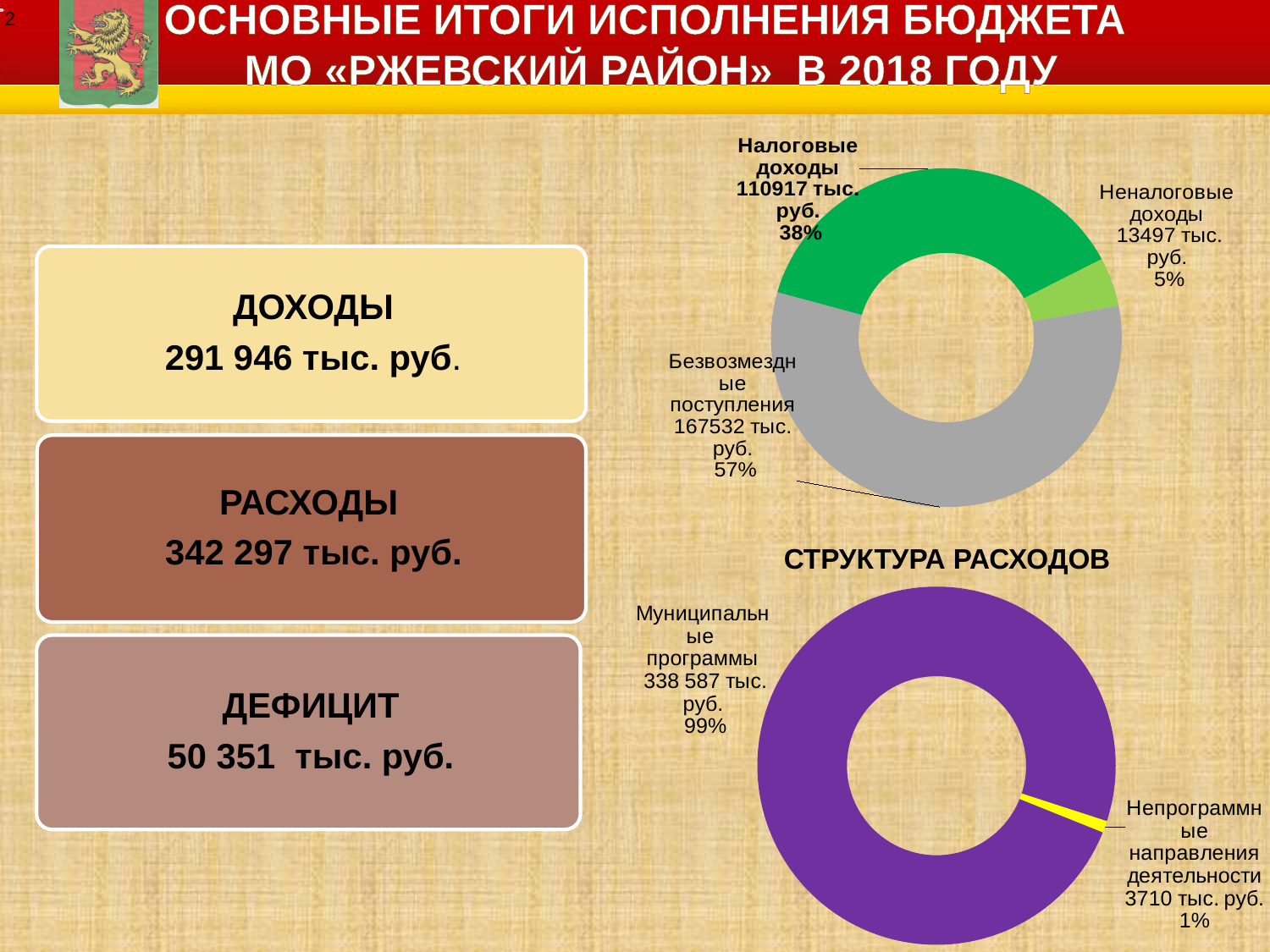
What kind of chart is the chart titled СТРУКТУРА РАСХОДОВ? Doughnut chart In the upper doughnut chart on the slide, how many categories are shown? 3 In the upper doughnut chart on the slide, which category is the largest? Безвозмездные поступления In the upper doughnut chart on the slide, what is the value for Налоговые доходы? 110917 тыс. руб. In the chart titled СТРУКТУРА РАСХОДОВ, which category is larger, Муниципальные программы or Непрограммные направления деятельности? Муниципальные программы In the upper doughnut chart on the slide, what share does Безвозмездные поступления have? 57% In the chart titled СТРУКТУРА РАСХОДОВ, what share does Непрограммные направления деятельности have? 1% In the chart titled СТРУКТУРА РАСХОДОВ, what is the value for Муниципальные программы? 338 587 тыс. руб. In the upper doughnut chart on the slide, which category is the smallest? Неналоговые доходы In the chart titled СТРУКТУРА РАСХОДОВ, what colour is the Непрограммные направления деятельности slice? Yellow In the upper doughnut chart on the slide, what is the difference between Безвозмездные поступления and Налоговые доходы? 56615 тыс. руб. In the upper doughnut chart on the slide, what is the value for Неналоговые доходы? 13497 тыс. руб.